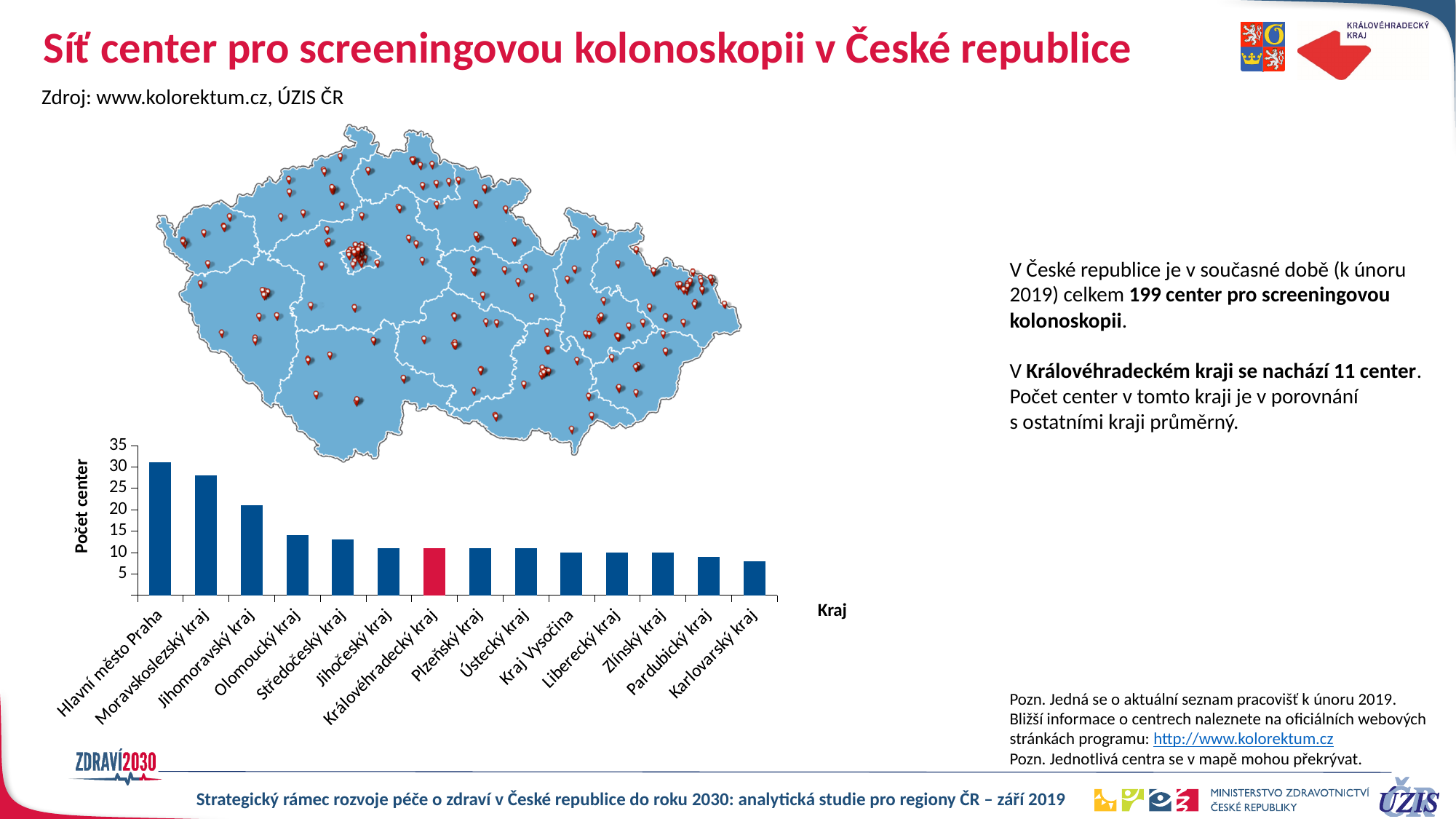
Is the value for Jihomoravský kraj greater or less than 25? less What kind of chart is shown at the bottom left of the slide? bar chart Do the bar values rise or fall from left to right along the x axis? fall Which region has the highest number of centres in the bar chart? Hlavní město Praha Which has more centres, Moravskoslezský kraj or Olomoucký kraj? Moravskoslezský kraj Which region has the lowest number of centres in the bar chart? Karlovarský kraj Is the value for Středočeský kraj greater or less than 10? greater How many screening colonoscopy centres are in Královéhradecký kraj according to the slide? 11 Is the value for Hlavní město Praha greater or less than 25? greater Which region's bar is highlighted in red in the bar chart? Královéhradecký kraj How many regions (kraje) are shown on the x axis of the bar chart? 14